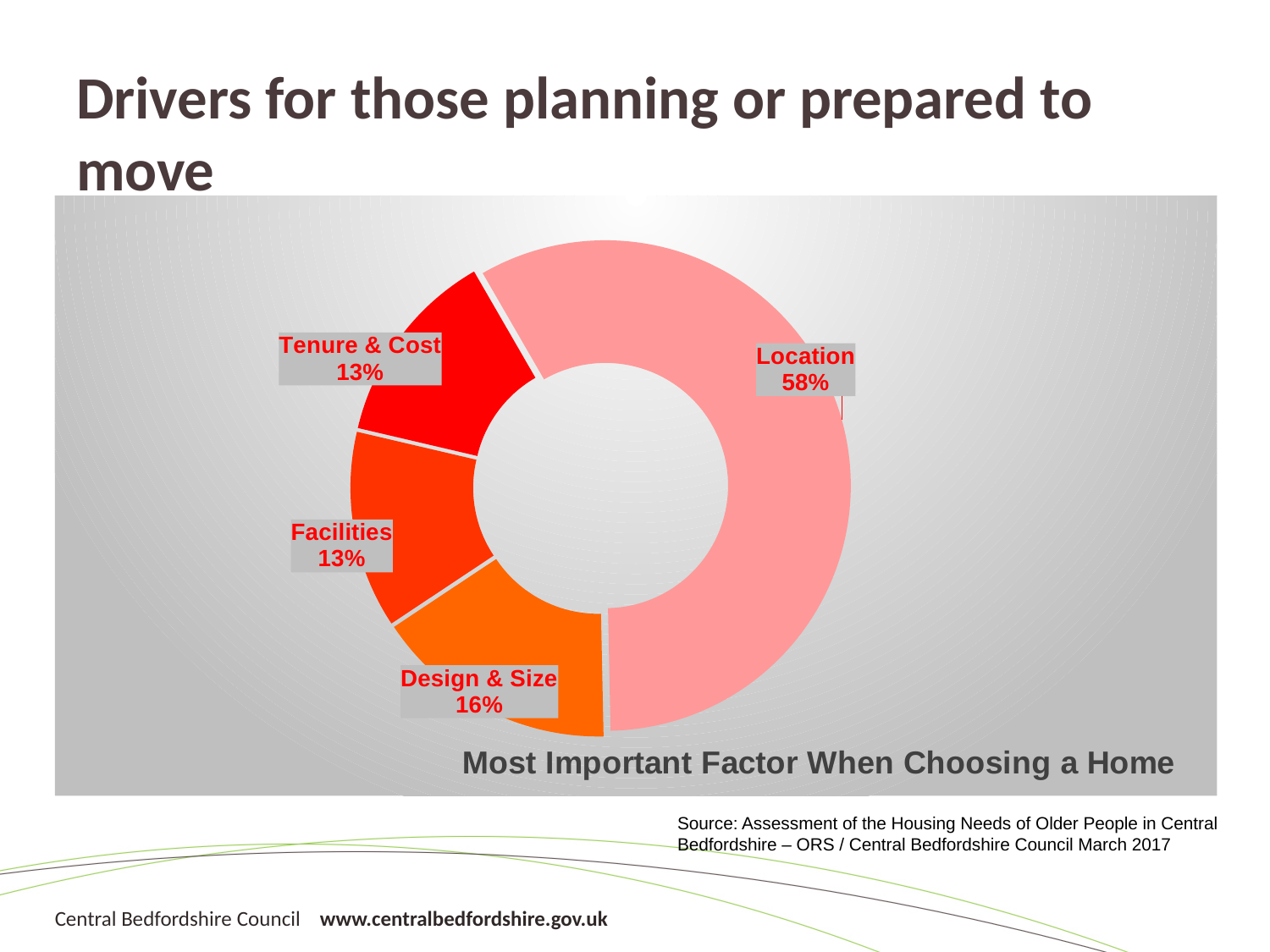
Which has a larger share, Design & Size or Facilities? Design & Size What is the title of the chart? Most Important Factor When Choosing a Home Which factor has the largest share of the chart? Location What percentage is shown for Design & Size? 16% Which has a larger share, Location or Tenure & Cost? Location What is the difference in percentage points between Design & Size and Facilities? 3 What is the difference in percentage points between Location and Design & Size? 42 What kind of chart is shown on the slide? Doughnut (pie) chart What share of the chart does Location account for? 58% How many factors (slices) are shown in the chart? 4 What percentage is shown for Tenure & Cost? 13% What percentage is shown for Facilities? 13%